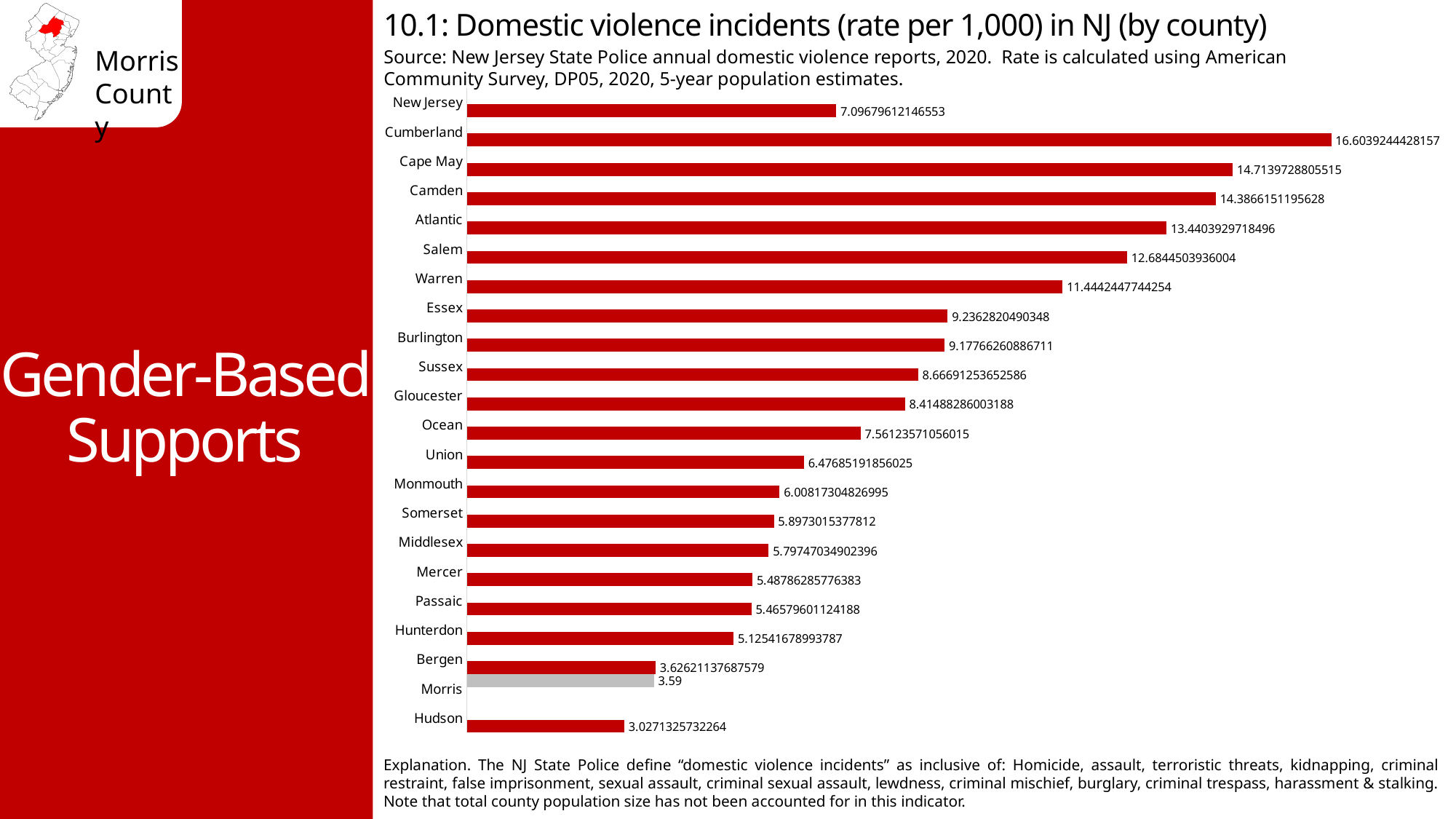
Which county has the lowest domestic violence incident rate? Hudson Which has a higher domestic violence incident rate, Cape May or Camden? Cape May Which county's bar is coloured grey instead of red? Morris What is the domestic violence incident rate per 1,000 for Hunterdon county? 5.12541678993787 Which has a higher domestic violence incident rate, Bergen or Morris? Bergen What kind of chart is shown on the slide? Bar chart How many bars (categories) are plotted in the chart? 22 What is the difference between the rates for Cumberland and Hudson counties? 13.5767918695893 What is the domestic violence incident rate per 1,000 for Cumberland county? 16.6039244428157 What is the domestic violence incident rate per 1,000 for Morris county? 3.59 Which county has the highest domestic violence incident rate? Cumberland What is the domestic violence incident rate per 1,000 shown for New Jersey overall? 7.09679612146553